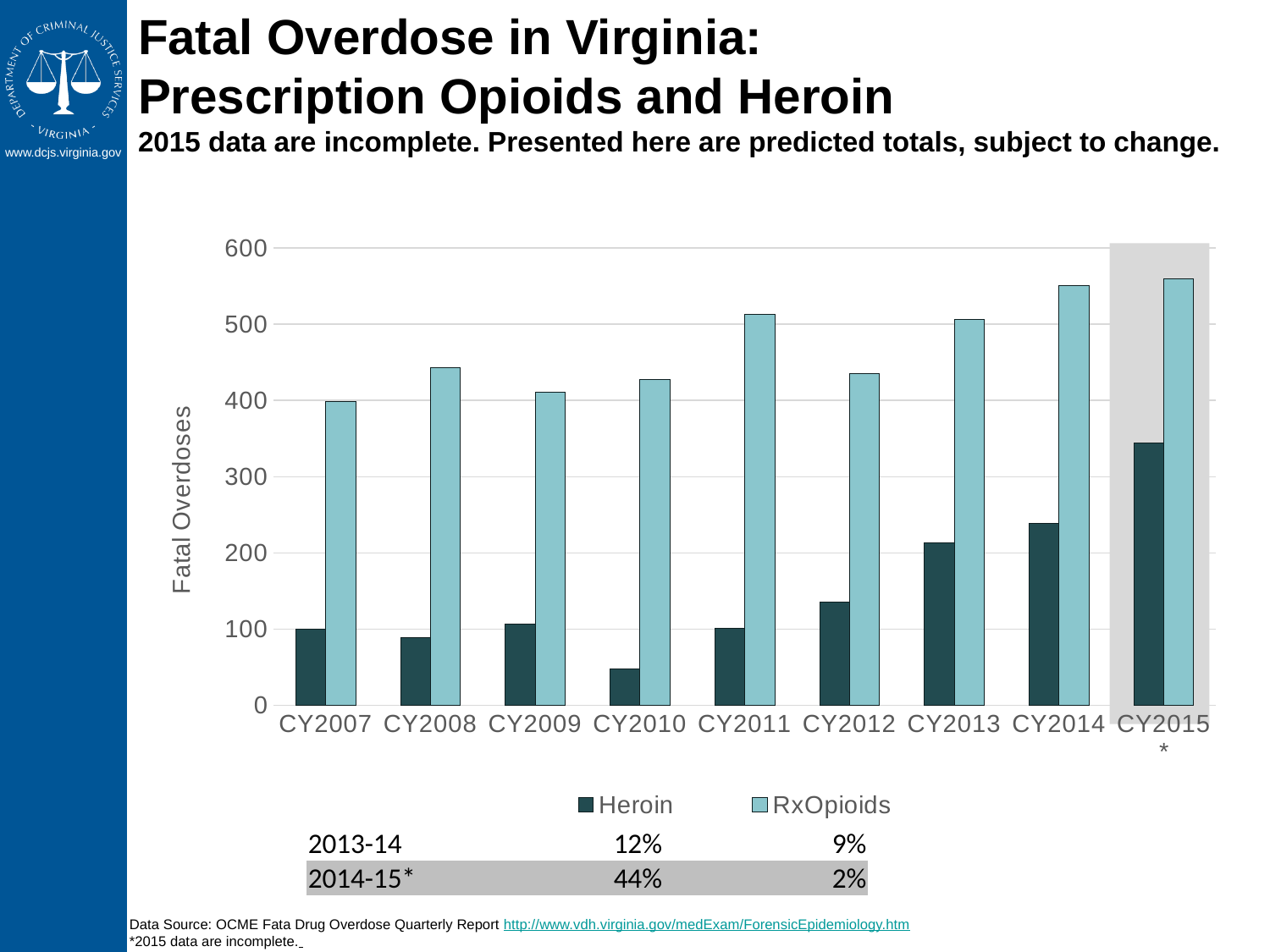
Is the Heroin value for CY2010 greater or less than 100? less Which year has the lowest Heroin value? CY2010 Is the Heroin value for CY2015 greater or less than 300? greater Which is larger, the RxOpioids value for CY2011 or for CY2012? CY2011 What is the label on the y axis? Fatal Overdoses Is the Heroin value for CY2013 greater or less than 200? greater How many calendar years are shown on the x axis? 9 Do the Heroin values rise or fall from CY2010 to CY2015? rise How many series does the legend list? 2 Which year has the highest Heroin value? CY2015 What kind of chart is shown on the slide? bar chart